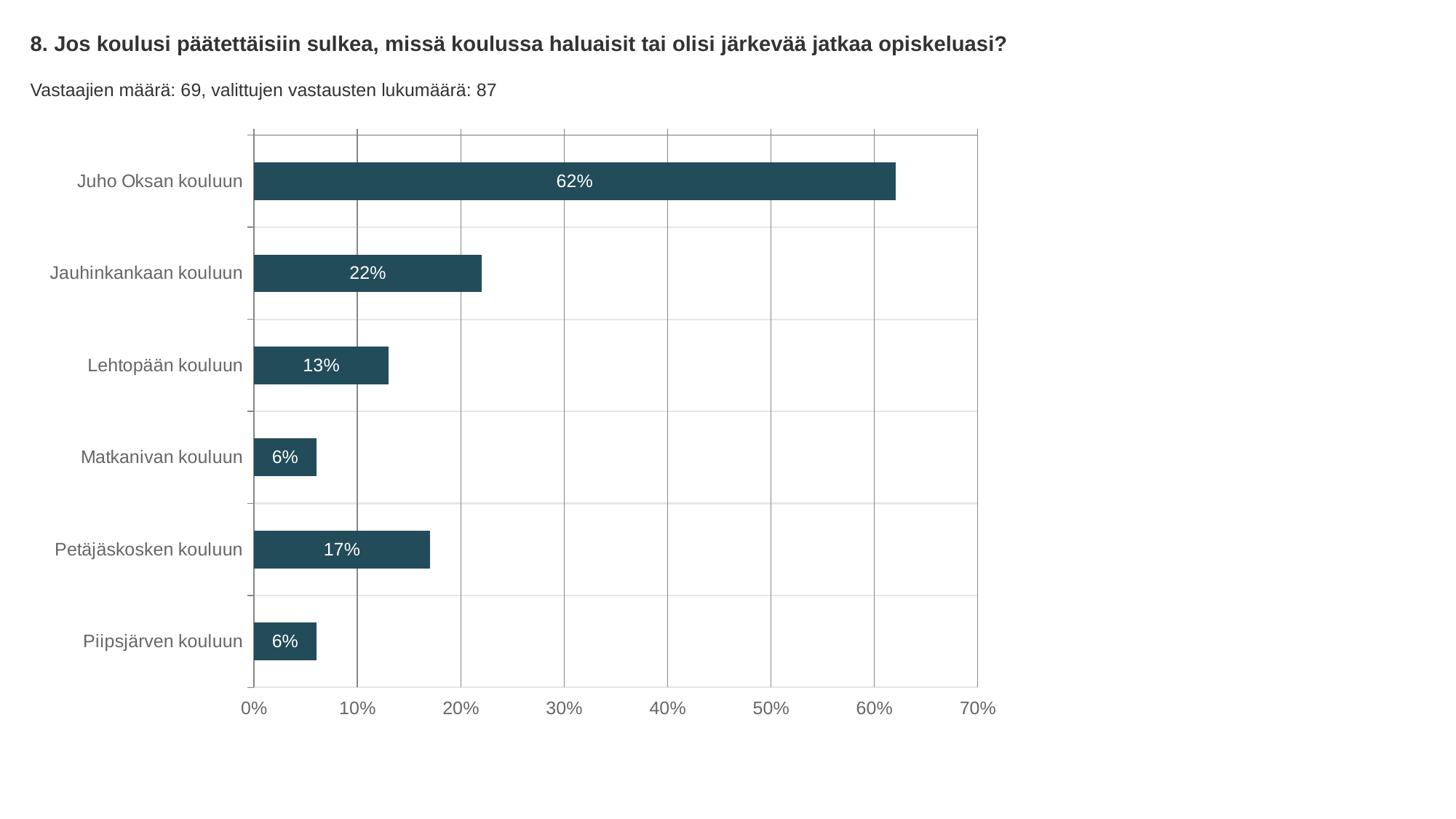
What kind of chart is shown on the slide? Bar chart How many schools are shown in the chart? 6 Which school has the highest percentage? Juho Oksan kouluun What is the value shown for Lehtopään kouluun? 13% What percentage of respondents chose Juho Oksan kouluun? 62% What is the value shown for Petäjäskosken kouluun? 17% Is the value for Lehtopään kouluun greater or less than 20%? less What is the difference in percentage points between Petäjäskosken kouluun and Lehtopään kouluun? 4 Is the value for Juho Oksan kouluun greater or less than 50%? greater Which is larger, the value for Jauhinkankaan kouluun or the value for Petäjäskosken kouluun? Jauhinkankaan kouluun How many respondents (vastaajien määrä) are stated on the slide? 69 What is the difference in percentage points between Juho Oksan kouluun and Jauhinkankaan kouluun? 40